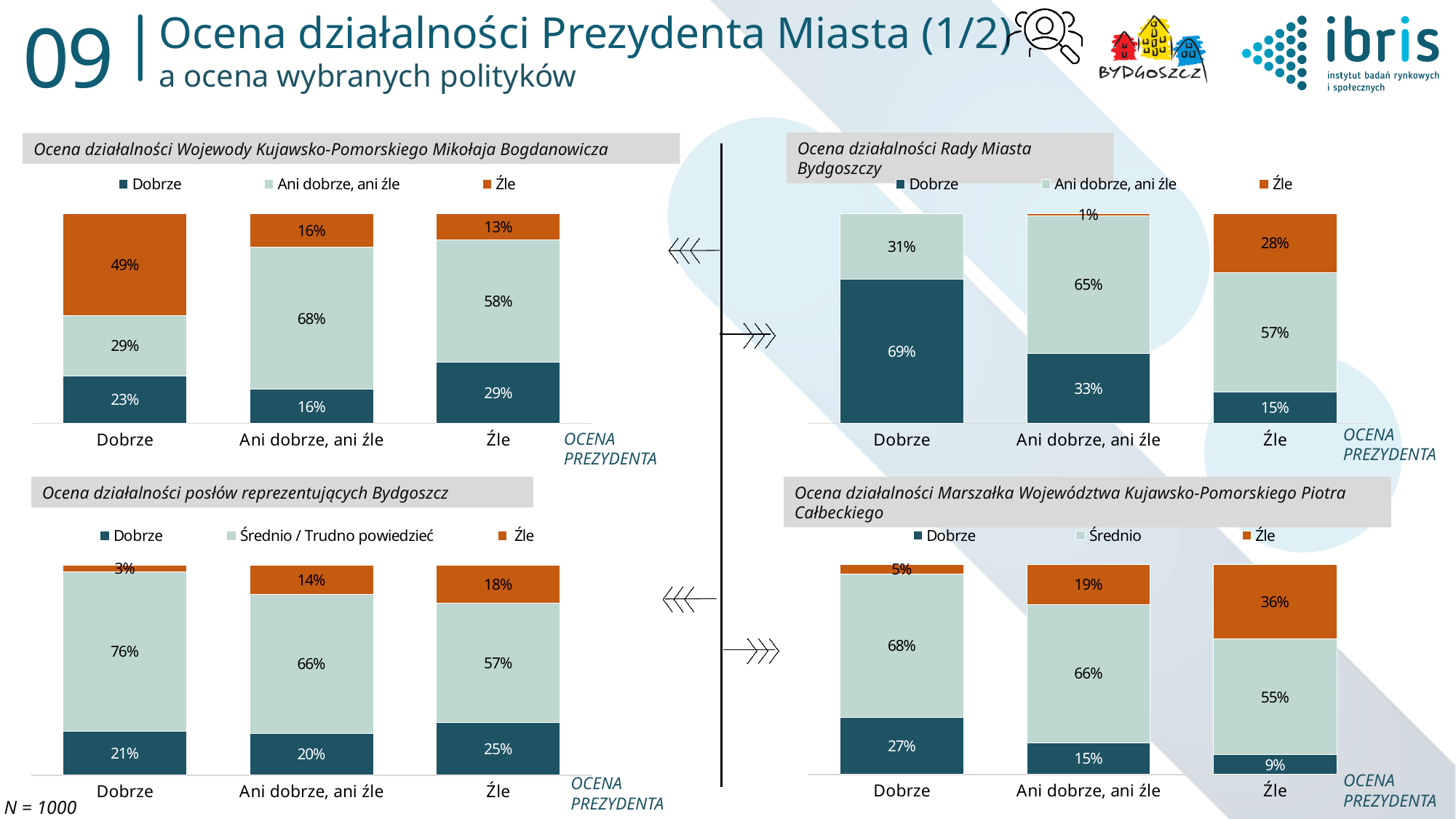
In the top-left chart (Ocena działalności Wojewody Kujawsko-Pomorskiego Mikołaja Bogdanowicza), what is the 'Ani dobrze, ani źle' value for the 'Ani dobrze, ani źle' category? 68% In the top-right chart (Ocena działalności Rady Miasta Bydgoszczy), what is the 'Dobrze' value for the 'Dobrze' category? 69% How many categories are shown on the x axis of the top-left chart (Ocena działalności Wojewody Kujawsko-Pomorskiego Mikołaja Bogdanowicza)? 3 In the top-left chart (Ocena działalności Wojewody Kujawsko-Pomorskiego Mikołaja Bogdanowicza), what is the 'Źle' value for the 'Dobrze' category? 49% In the top-right chart (Ocena działalności Rady Miasta Bydgoszczy), which category has the highest 'Źle' value? Źle What kind of chart is the top-right chart (Ocena działalności Rady Miasta Bydgoszczy)? Stacked bar chart How many series does the legend of the bottom-right chart (Ocena działalności Marszałka Województwa Kujawsko-Pomorskiego Piotra Całbeckiego) list? 3 In the bottom-right chart (Ocena działalności Marszałka Województwa Kujawsko-Pomorskiego Piotra Całbeckiego), is the 'Dobrze' value larger for the 'Dobrze' category or the 'Źle' category? Dobrze In the bottom-left chart (Ocena działalności posłów reprezentujących Bydgoszcz), what is the 'Średnio / Trudno powiedzieć' value for the 'Dobrze' category? 76% In the bottom-left chart (Ocena działalności posłów reprezentujących Bydgoszcz), which category has the lowest 'Źle' value? Dobrze In the top-right chart (Ocena działalności Rady Miasta Bydgoszczy), what is the difference between the 'Dobrze' values for the 'Dobrze' and 'Źle' categories? 54% In the bottom-right chart (Ocena działalności Marszałka Województwa Kujawsko-Pomorskiego Piotra Całbeckiego), what is the 'Źle' value for the 'Źle' category? 36%